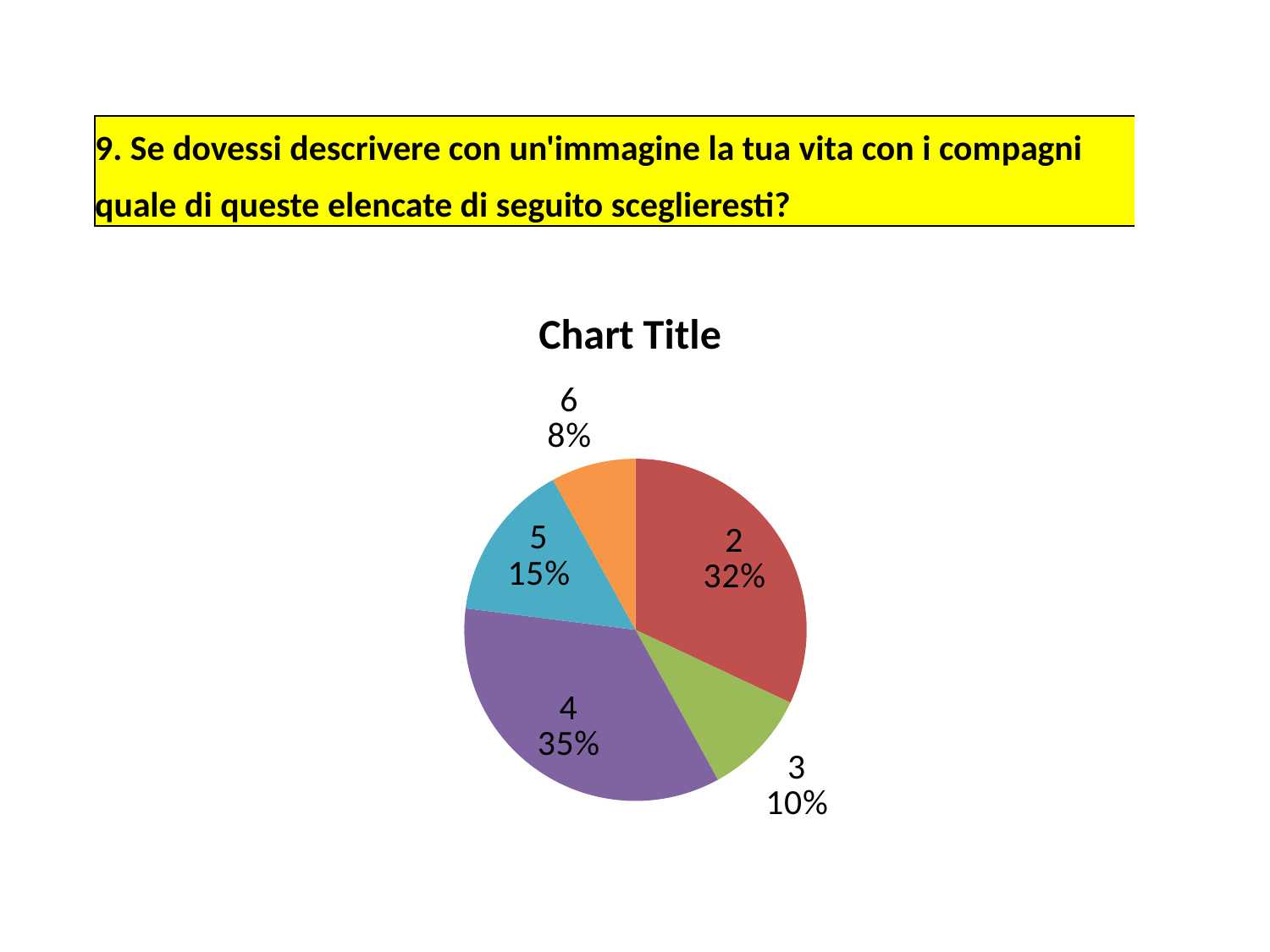
What percentage is shown for slice 5? 15% What percentage is shown for slice 4? 35% What type of chart is shown on the slide? pie chart How many slices does the pie chart have? 5 Which slice has the smallest share of the pie? 6 What percentage is shown for slice 6? 8% What percentage is shown for slice 3? 10% What percentage is shown for slice 2? 32% Which slice has the largest share of the pie? 4 What is the title of the chart? Chart Title Which slice is larger, slice 5 or slice 3? 5 What is the difference in percentage points between slice 4 and slice 2? 3